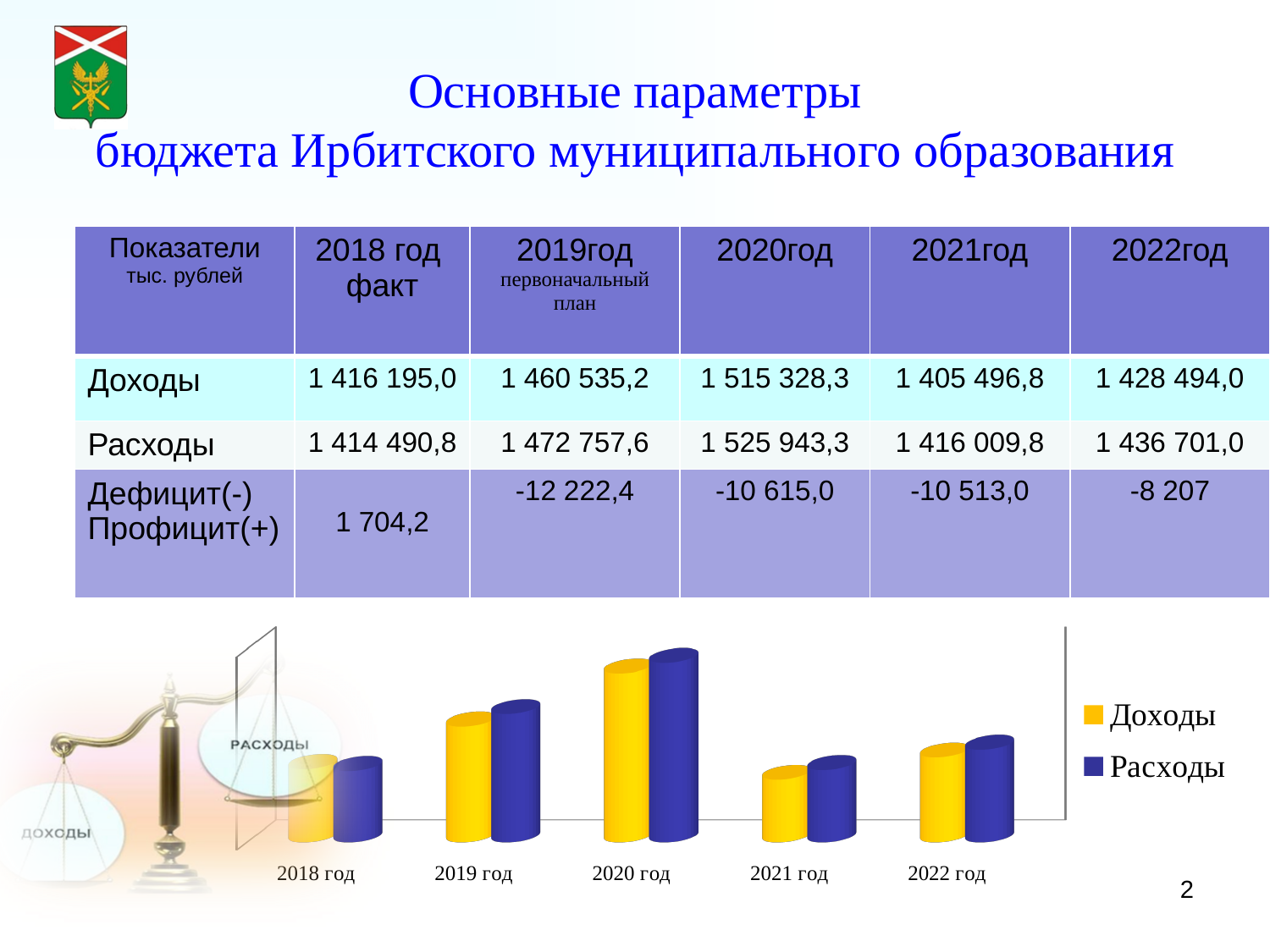
In which year is the Расходы bar the tallest? 2020 год According to the table on the slide, what is the value of Доходы for 2020год? 1 515 328,3 How many series does the chart legend list? 2 In which year is the Доходы bar the tallest? 2020 год Which year has the taller Доходы bar: 2020 год or 2021 год? 2020 год In 2019 год, which bar is taller: Доходы or Расходы? Расходы In which year is the Доходы bar the shortest? 2021 год Which series is shown in yellow in the chart legend? Доходы What kind of chart is shown at the bottom of the slide? Bar chart How many year categories are shown on the chart's x axis? 5 Which series is shown in blue in the chart legend? Расходы From 2018 год to 2020 год, do the Доходы bars rise or fall? Rise